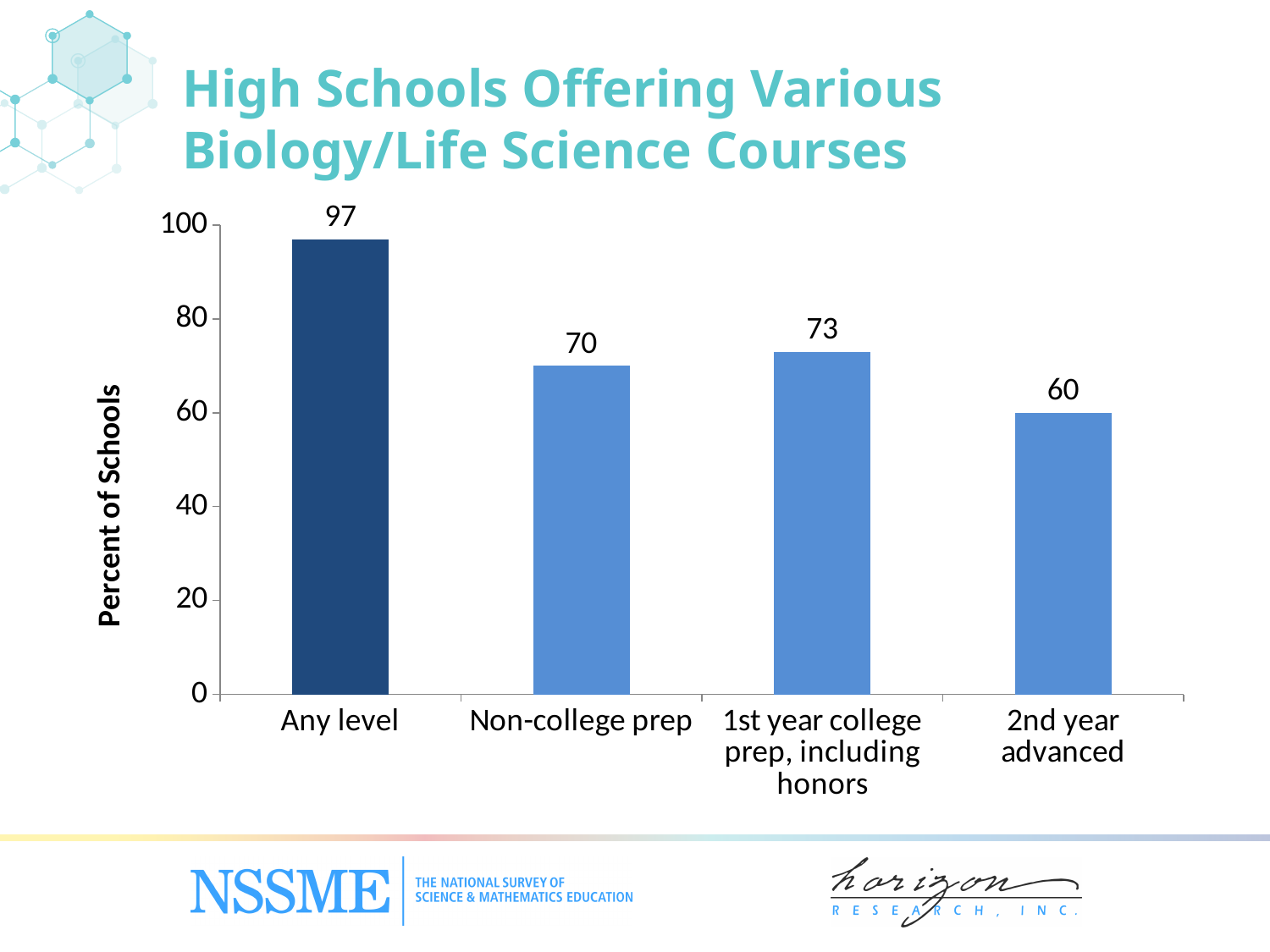
What kind of chart is shown on the slide? Bar chart How many categories are shown on the x axis? 4 What is the value for 1st year college prep, including honors? 73 What percent of schools offer biology/life science at any level? 97 What is the difference between the values for Any level and 2nd year advanced? 37 Which category has the highest percent of schools? Any level What is the label of the y axis? Percent of Schools Which is larger, the value for Non-college prep or the value for 2nd year advanced? Non-college prep What is the value for 2nd year advanced? 60 Which category has the lowest percent of schools? 2nd year advanced What is the value for Non-college prep? 70 What is the difference between the values for 1st year college prep, including honors and Non-college prep? 3